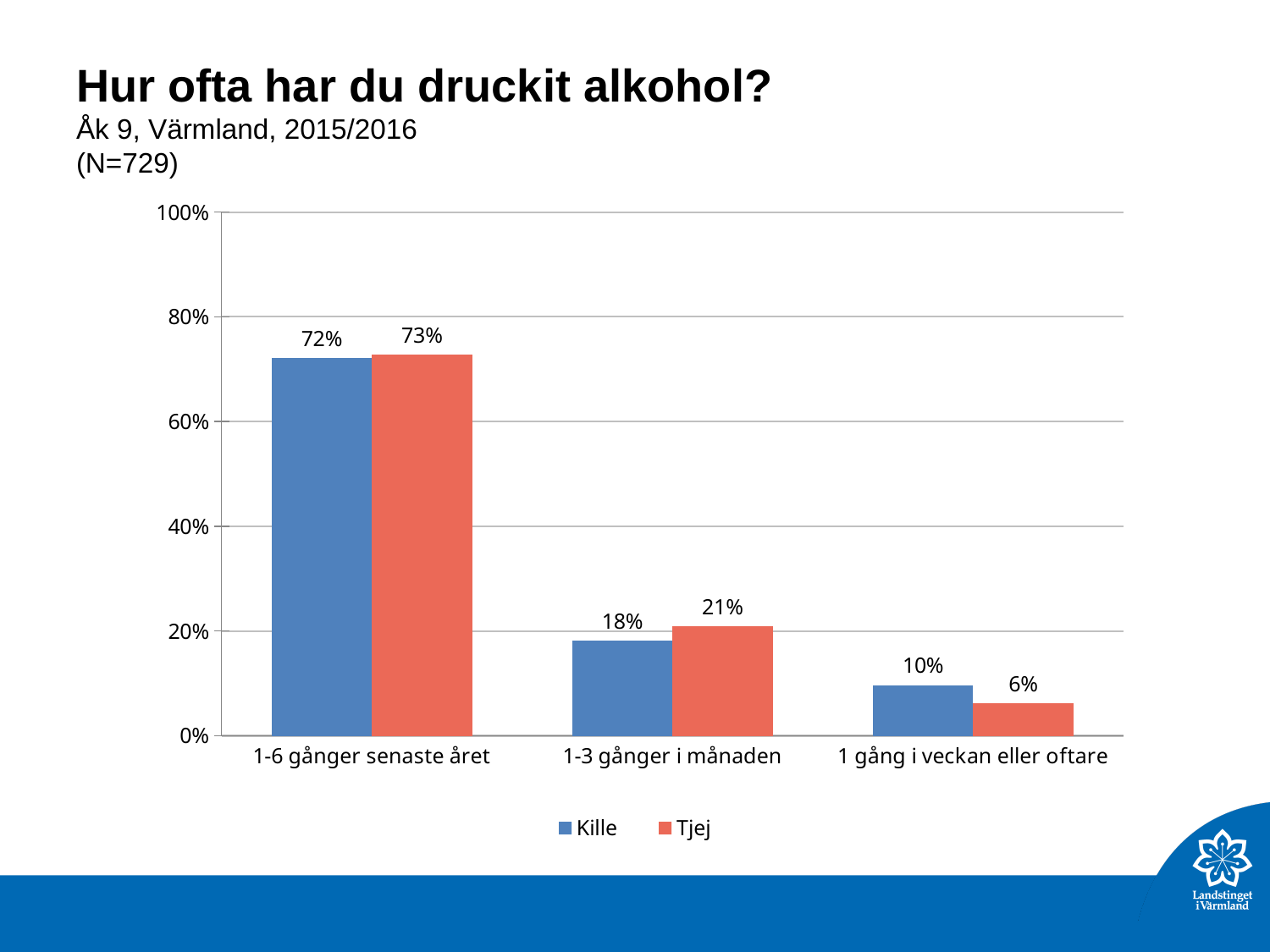
How many series does the legend list? 2 In the category '1 gång i veckan eller oftare', which series has the larger value, Kille or Tjej? Kille What kind of chart is shown on the slide? Bar chart What is the value for Kille in the category '1-6 gånger senaste året'? 72% Which category has the lowest value for Tjej? 1 gång i veckan eller oftare Which category has the highest value for Kille? 1-6 gånger senaste året What is the value for Tjej in the category '1-3 gånger i månaden'? 21% What is the difference between Tjej and Kille in the category '1-3 gånger i månaden'? 3% How many categories are shown on the x axis? 3 Which series is shown in orange in the legend? Tjej What is the value for Tjej in the category '1 gång i veckan eller oftare'? 6% Is the value for Kille in '1-6 gånger senaste året' greater or less than 60%? greater